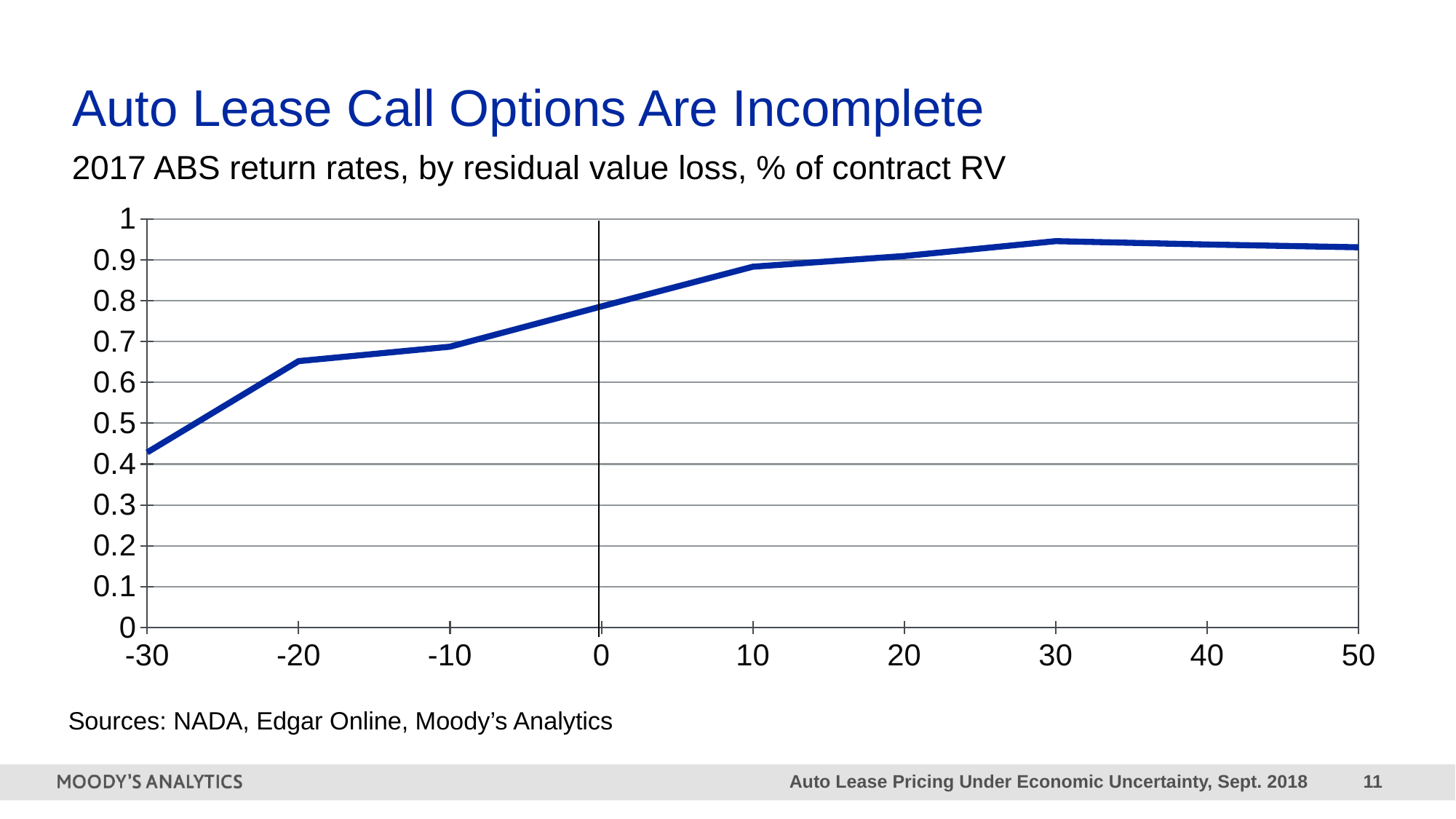
What is the title of the slide containing the chart? Auto Lease Call Options Are Incomplete Is the value at x = -30 greater or less than 0.5? less What does the chart subtitle say is being plotted? 2017 ABS return rates, by residual value loss, % of contract RV Is the value at x = 0 greater or less than 0.7? greater Is the value at x = 10 greater or less than 0.8? greater At which x-axis value is the plotted return rate lowest? -30 Which has the larger value, x = -30 or x = 50? 50 Which has the larger value, x = -10 or x = 20? 20 What kind of chart is shown on the slide? line chart Does the line generally rise or fall as x increases from -30 to 30? rise